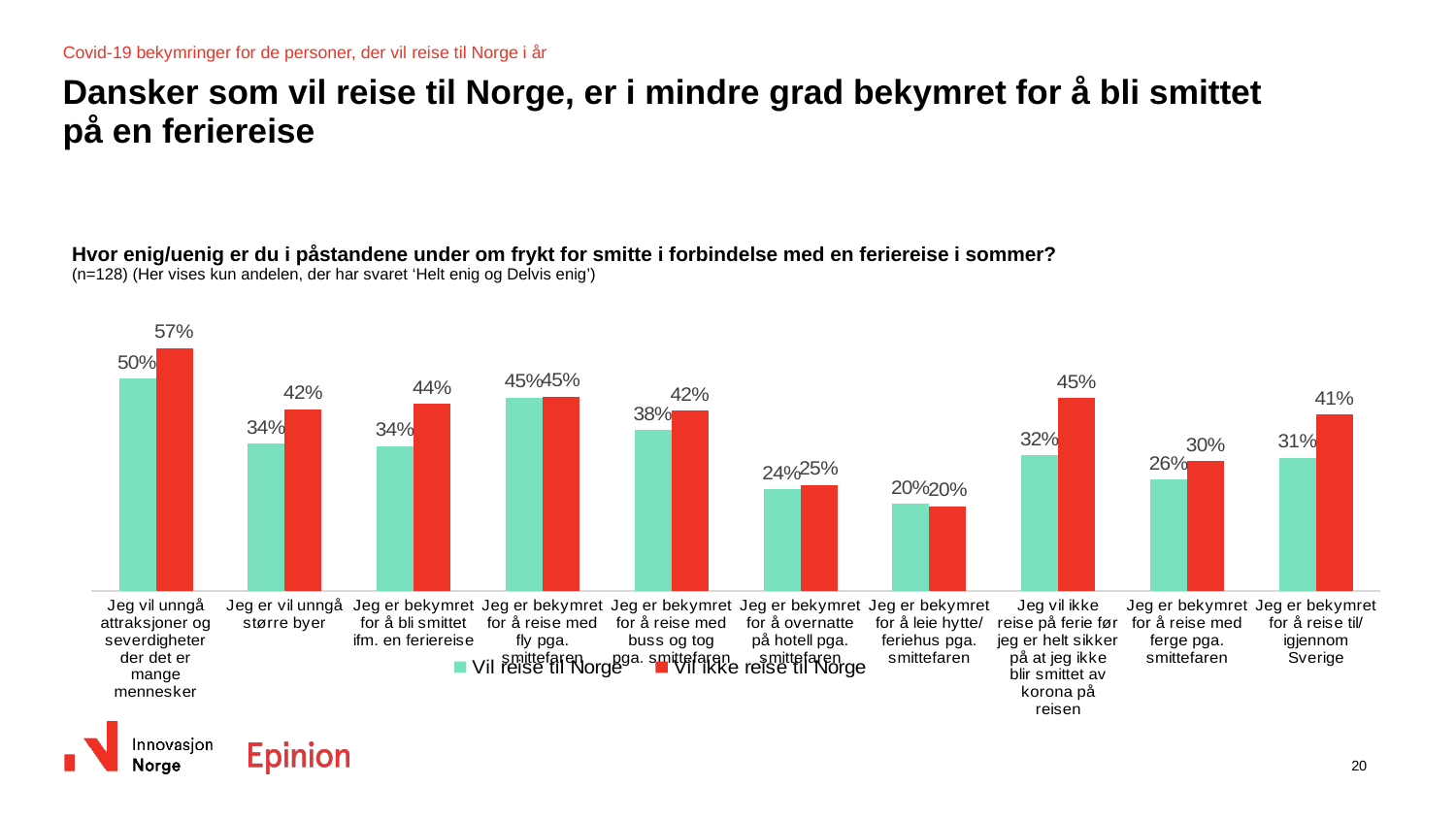
For the statement 'Jeg er bekymret for å bli smittet ifm. en feriereise', which series has the larger value? Vil ikke reise til Norge How many series does the legend list? 2 Which statement has the lowest value for the 'Vil ikke reise til Norge' series? Jeg er bekymret for å leie hytte/ feriehus pga. smittefaren What is the value for 'Vil ikke reise til Norge' for the statement 'Jeg er bekymret for å reise til/igjennom Sverige'? 41% What is the difference between the two series for the statement 'Jeg er bekymret for å reise med fly pga. smittefaren'? 0 percentage points What is the value for 'Vil reise til Norge' for the statement 'Jeg er bekymret for å reise med buss og tog pga. smittefaren'? 38% Which series is shown in red in the legend? Vil ikke reise til Norge What is the difference between 'Vil ikke reise til Norge' and 'Vil reise til Norge' for the statement 'Jeg vil ikke reise på ferie før jeg er helt sikker på at jeg ikke blir smittet av korona på reisen'? 13 percentage points Which statement has the highest value for the 'Vil reise til Norge' series? Jeg vil unngå attraksjoner og severdigheter der det er mange mennesker What kind of chart is shown on the slide? Bar chart How many categories (statements) are shown on the x axis? 10 What is the value for 'Vil ikke reise til Norge' for the statement 'Jeg vil unngå attraksjoner og severdigheter der det er mange mennesker'? 57%